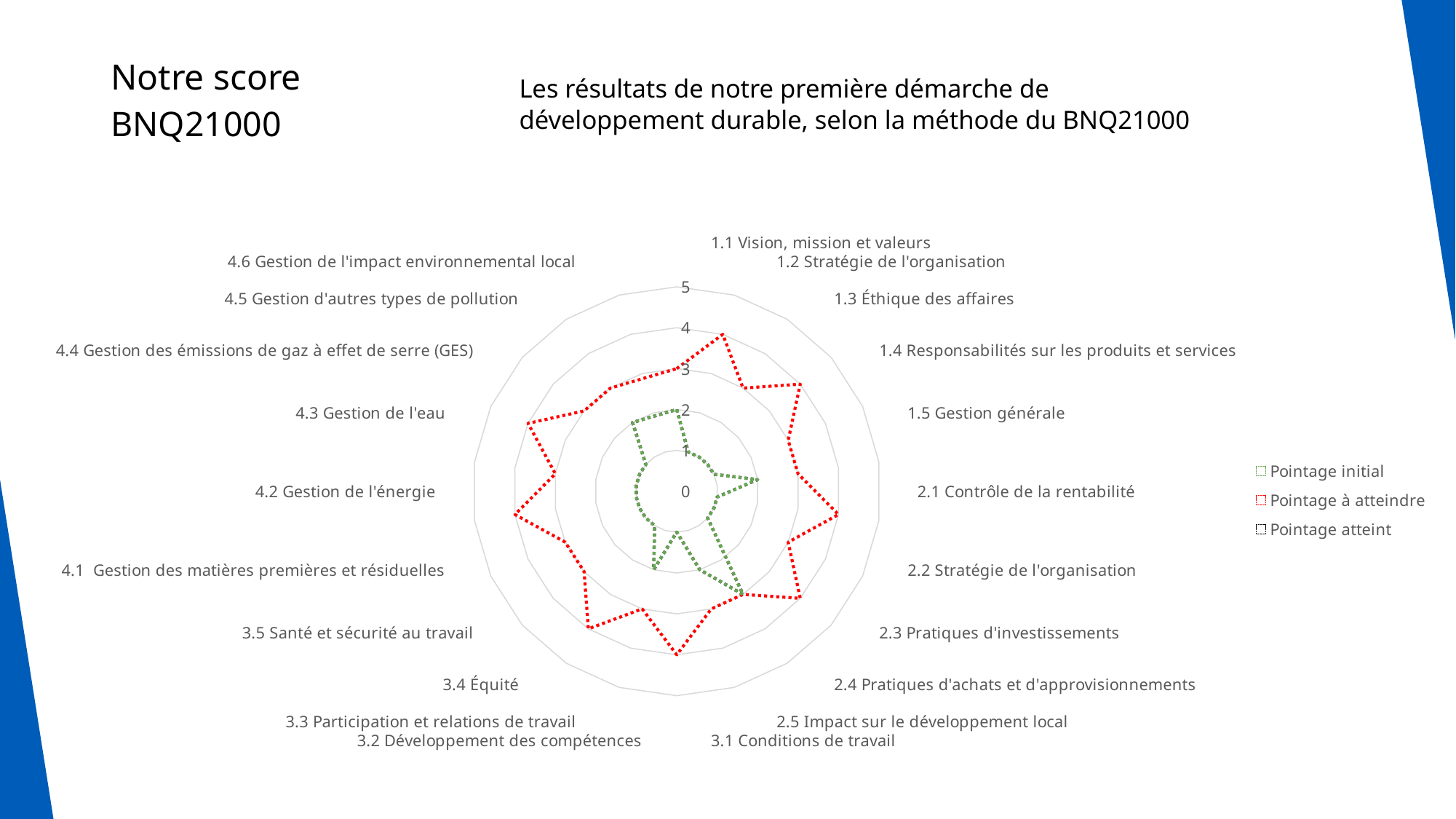
For 2.1 Contrôle de la rentabilité, which is larger: Pointage initial or Pointage à atteindre? Pointage à atteindre How many series does the legend list? 3 What is the highest value shown on the chart's axis scale? 5 What kind of chart is shown on the slide? Radar chart Is the Pointage à atteindre value for 4.2 Gestion de l'énergie greater or less than 3? greater Is the Pointage initial value for 3.4 Équité greater or less than 2? less What are the three series named in the legend? Pointage initial, Pointage à atteindre, Pointage atteint How many categories are plotted around the radar chart? 21 Is the Pointage initial value for 1.1 Vision, mission et valeurs greater or less than 3? less